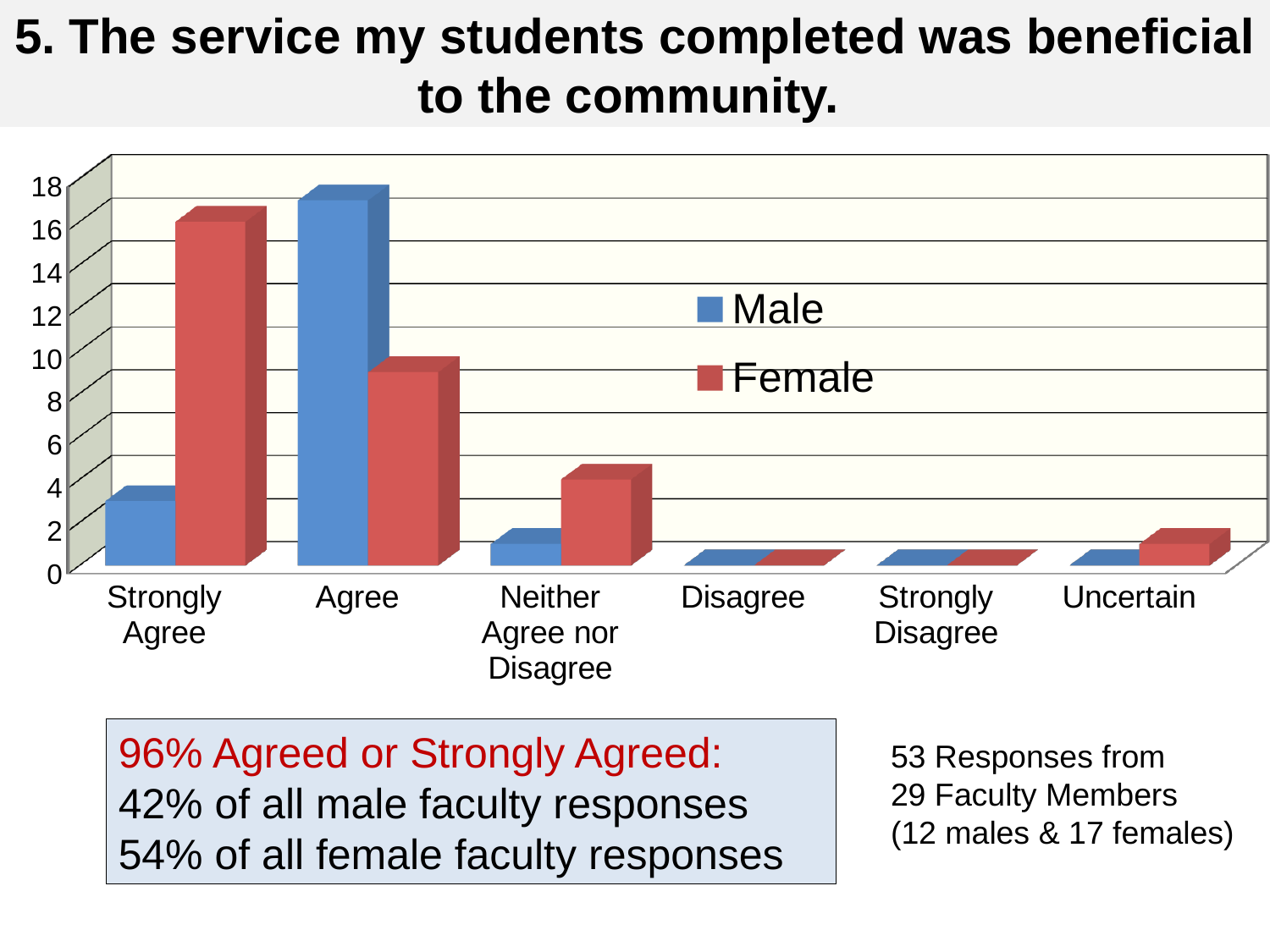
For the Strongly Agree category, which is larger, the Male or the Female value? Female Is the Female value for Neither Agree nor Disagree greater or less than 8? less Is the Male value for Strongly Agree greater or less than 6? less For the Agree category, which is larger, the Male or the Female value? Male Which category has the highest Female value? Strongly Agree How many response categories are shown on the x axis? 6 How many series does the legend list? 2 What kind of chart is shown on the slide? bar chart Is the Female value for Strongly Agree greater or less than 12? greater What colour represents the Female series in the chart? red Which category has the highest Male value? Agree